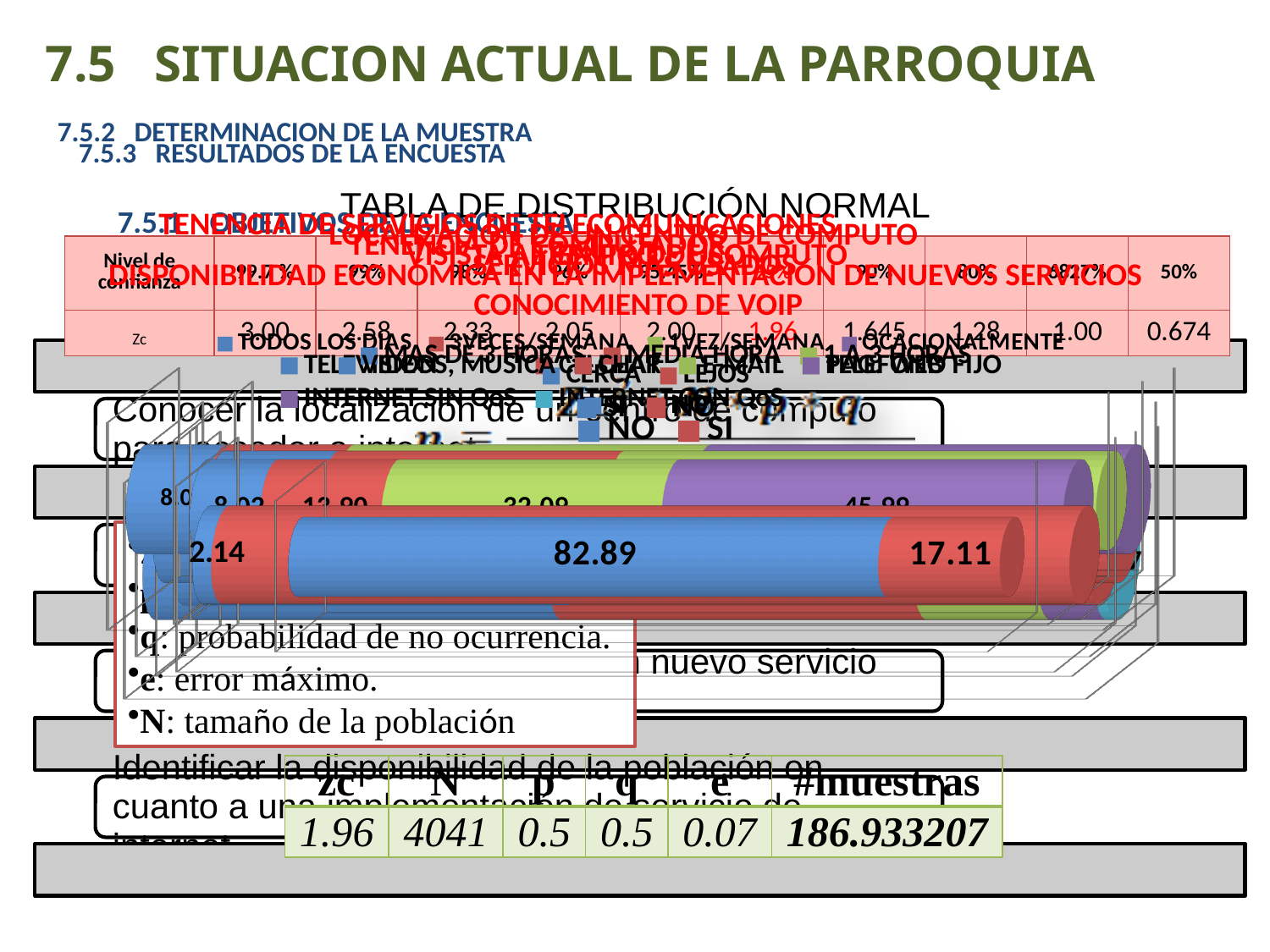
In the front-most bar chart (the bar labelled 82.89 and 17.11), what is the value of the red segment? 17.11 In the front-most bar chart, what is the total of the two segments 82.89 and 17.11? 100.00 Which two entries does the front-most legend (just above the bars) list? NO, SI What kind of chart is the front-most chart with the segments 82.89 and 17.11? bar chart In the front-most bar chart (the bar labelled 82.89 and 17.11), what is the value of the larger blue segment? 82.89 How many entries does the front-most legend (NO / SI) list? 2 In the front-most bar chart, what is the difference between the segment values 82.89 and 17.11? 65.78 In the front-most bar chart, which segment is larger, the one labelled 82.89 or the one labelled 17.11? 82.89